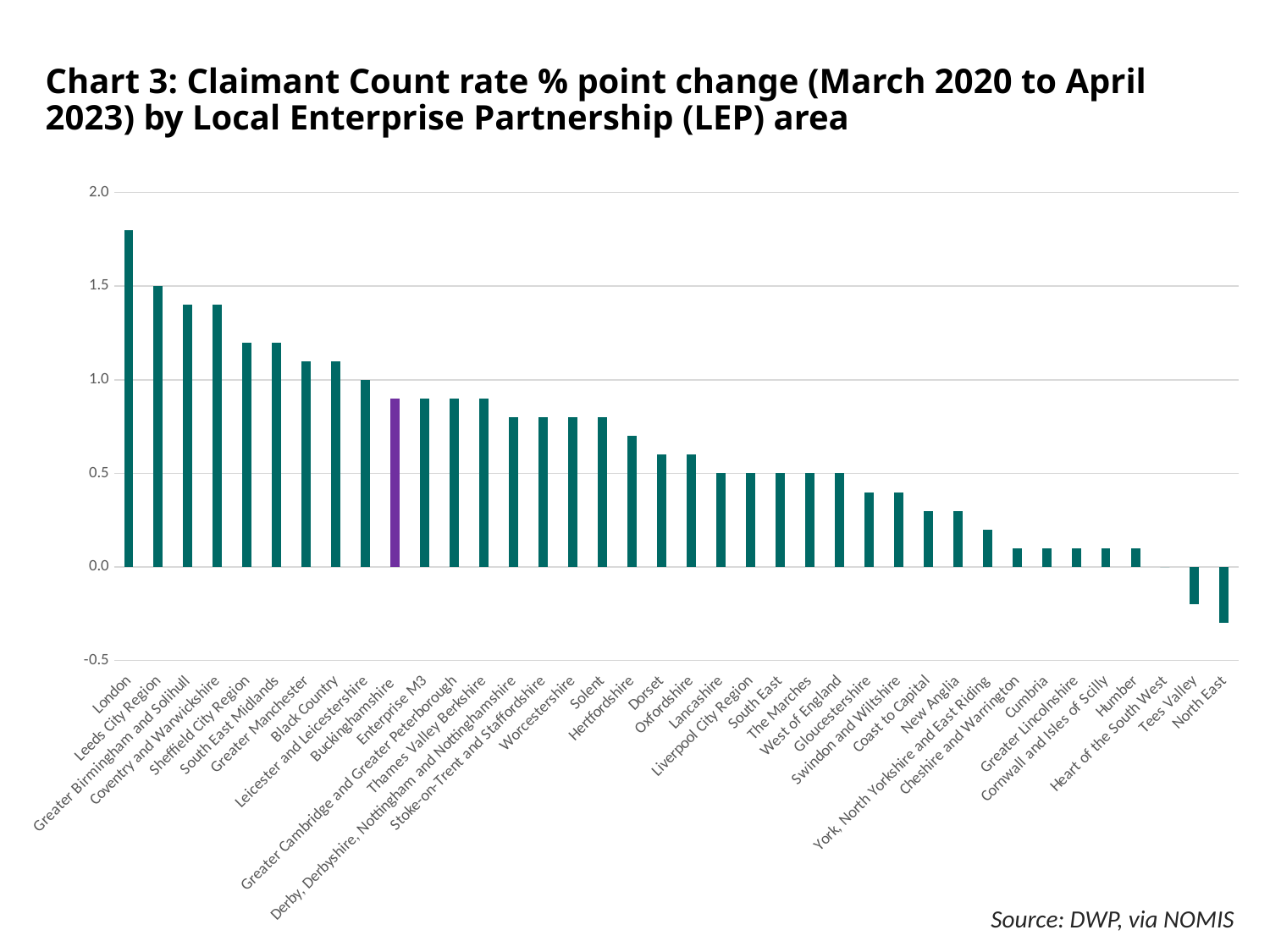
Is the value for Tees Valley greater or less than 0.0? less Do the values rise or fall moving from left to right along the x axis? Fall What kind of chart is shown on the slide? Bar chart What is the Claimant Count rate % point change for West of England? 0.5 Which LEP area has the highest Claimant Count rate % point change? London What is the Claimant Count rate % point change for Leicester and Leicestershire? 1.0 Which LEP area has the lowest Claimant Count rate % point change? North East Is the value for London greater or less than 1.5? greater Which has a larger value, Greater Manchester or Dorset? Greater Manchester What is the Claimant Count rate % point change for Leeds City Region? 1.5 Is the value for Buckinghamshire greater or less than 1.0? less Which LEP area's bar is coloured purple rather than green? Buckinghamshire